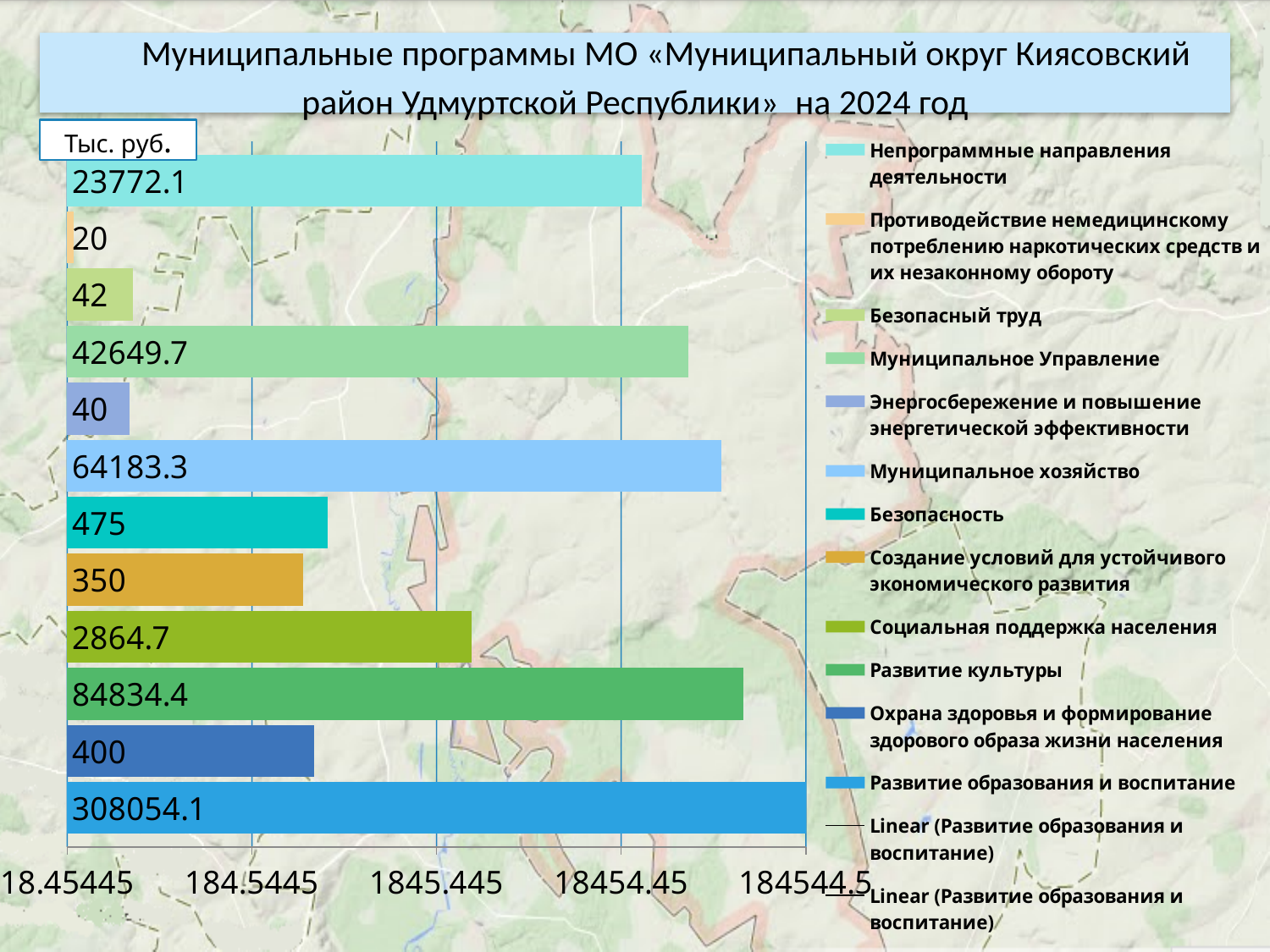
What unit is indicated for the values in the chart? Тыс. руб. What kind of chart is shown on the slide? Bar chart What is the value for Развитие образования и воспитание? 308054.1 Which program has the highest value? Развитие образования и воспитание What is the value for Муниципальное хозяйство? 64183.3 Which is larger: the value for Безопасность or the value for Охрана здоровья и формирование здорового образа жизни населения? Безопасность What is the value for Социальная поддержка населения? 2864.7 How many bars are plotted in the chart? 12 What is the value for Развитие культуры? 84834.4 Which program has the lowest value? Противодействие немедицинскому потреблению наркотических средств и их незаконному обороту What is the value for Безопасность? 475 What is the difference between the values for Муниципальное хозяйство and Муниципальное Управление? 21533.6